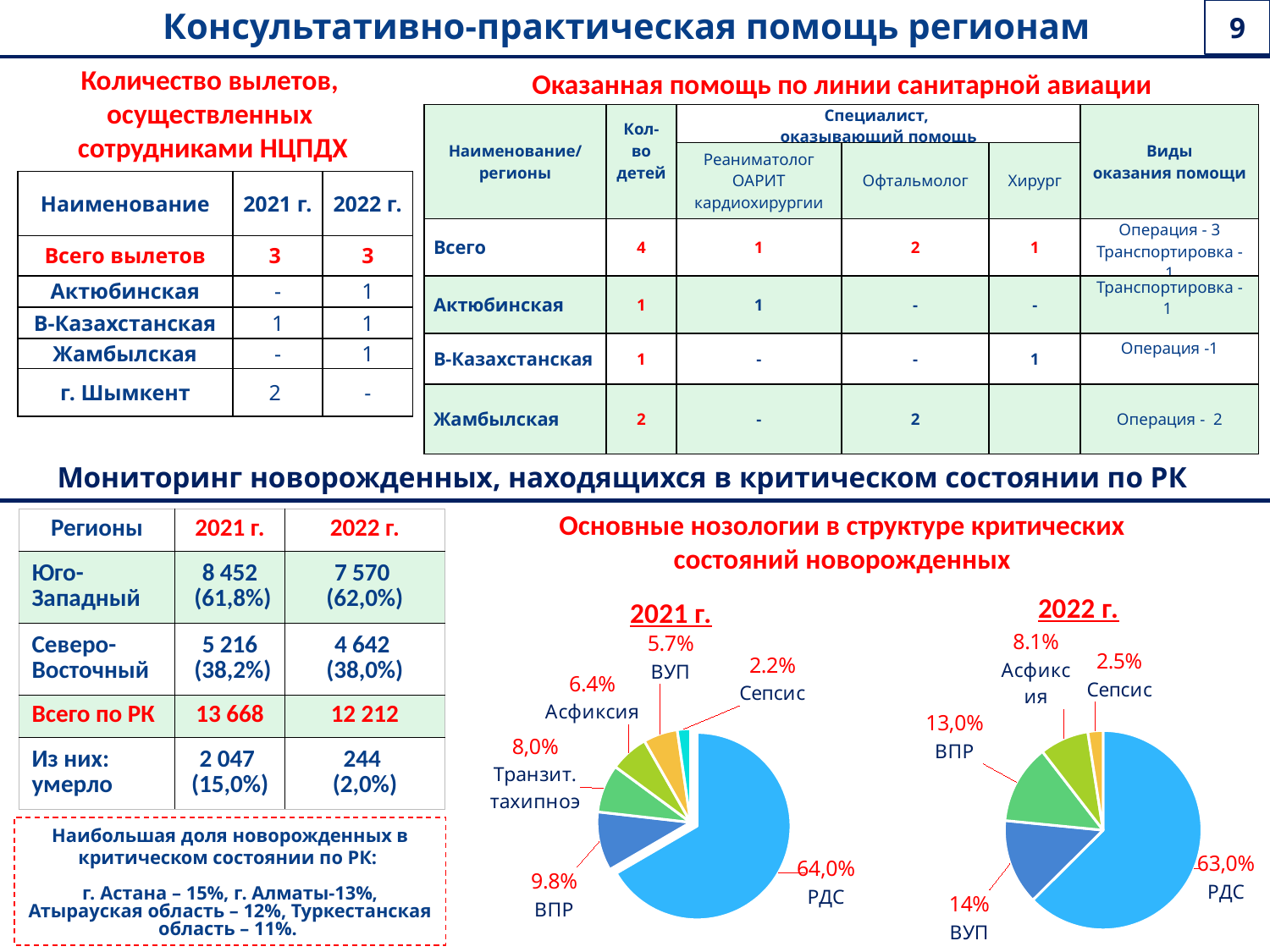
How many slices does the 2021 г. pie chart have? 6 In the 2022 г. pie chart, which category has the smallest slice? Сепсис In the 2021 г. pie chart, which category has the smallest slice? Сепсис In the 2022 г. pie chart, which category has the largest slice? РДС In the 2021 г. pie chart, what share is labelled for РДС? 64,0% What type of chart is used to show the 2022 г. data on the slide? Pie chart In the 2022 г. pie chart, what share is labelled for Асфиксия? 8.1% In the 2021 г. pie chart, what share is labelled for ВПР? 9.8% How many slices does the 2022 г. pie chart have? 5 In the 2022 г. pie chart, what share is labelled for ВУП? 14% In the 2021 г. pie chart, what share is labelled for Сепсис? 2.2% In the 2021 г. pie chart, which is larger: Асфиксия or ВУП? Асфиксия